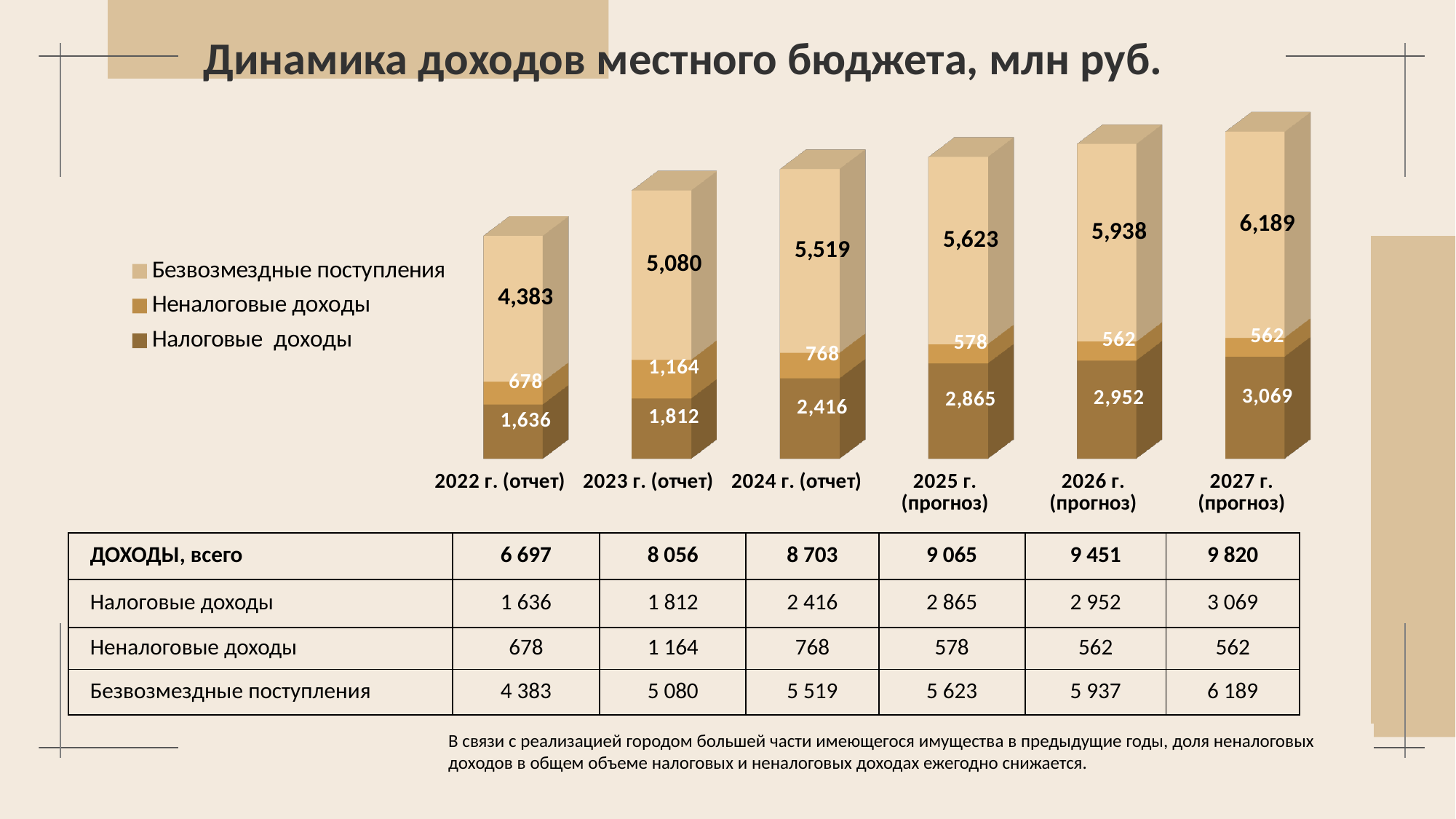
Which year has the lowest value for Безвозмездные поступления? 2022 г. (отчет) Which year has the highest value for Неналоговые доходы? 2023 г. (отчет) What is the total of the stacked bar for 2022 г. (отчет)? 6 697 Which year has the highest value for Налоговые доходы? 2027 г. (прогноз) How many series does the chart legend list? 3 How many years are shown on the x axis of the chart? 6 What is the value of Безвозмездные поступления for 2027 г. (прогноз)? 6,189 Which year has the larger value for Неналоговые доходы: 2023 г. (отчет) or 2024 г. (отчет)? 2023 г. (отчет) What is the difference between Налоговые доходы in 2027 г. (прогноз) and in 2022 г. (отчет)? 1,433 What is the value of Неналоговые доходы for 2023 г. (отчет)? 1,164 What is the value of Налоговые доходы for 2024 г. (отчет)? 2,416 What kind of chart is shown on the slide? Stacked bar chart